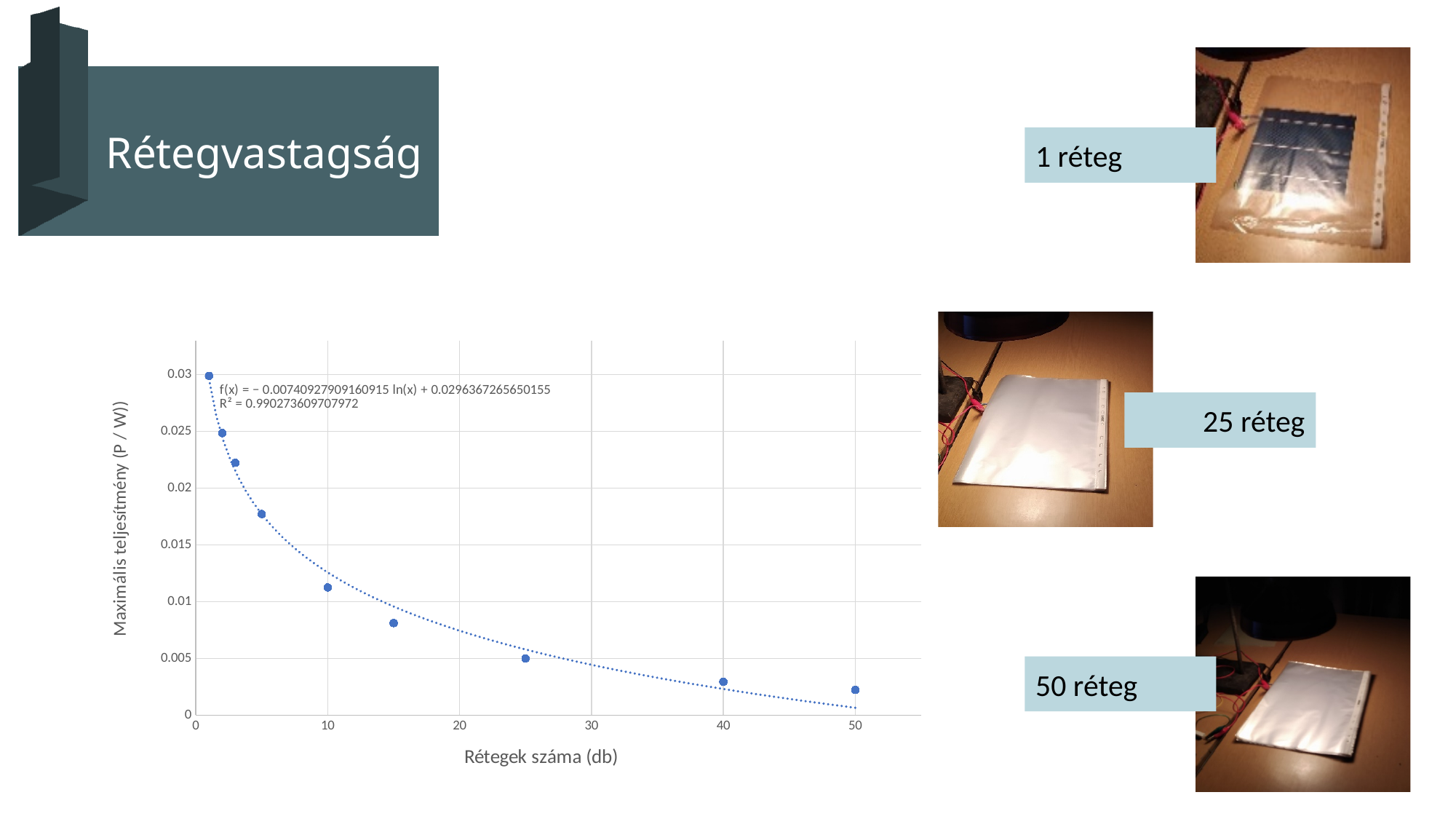
At which number of layers is the maximum power (Maximális teljesítmény) lowest? 50 Is the value for 3 layers greater or less than 0.02? greater What is the title of the x axis of the chart? Rétegek száma (db) Is the value for 50 layers greater or less than 0.005? less How many data points are plotted in the chart? 9 Which has the larger maximum power: 10 layers or 15 layers? 10 layers What kind of chart is shown on the slide? scatter chart Do the plotted values rise or fall as the number of layers (Rétegek száma) increases? fall At which number of layers is the maximum power (Maximális teljesítmény) highest? 1 What R² value is shown for the trendline in the chart? 0.990273609707972 Is the value for 15 layers greater or less than 0.01? less